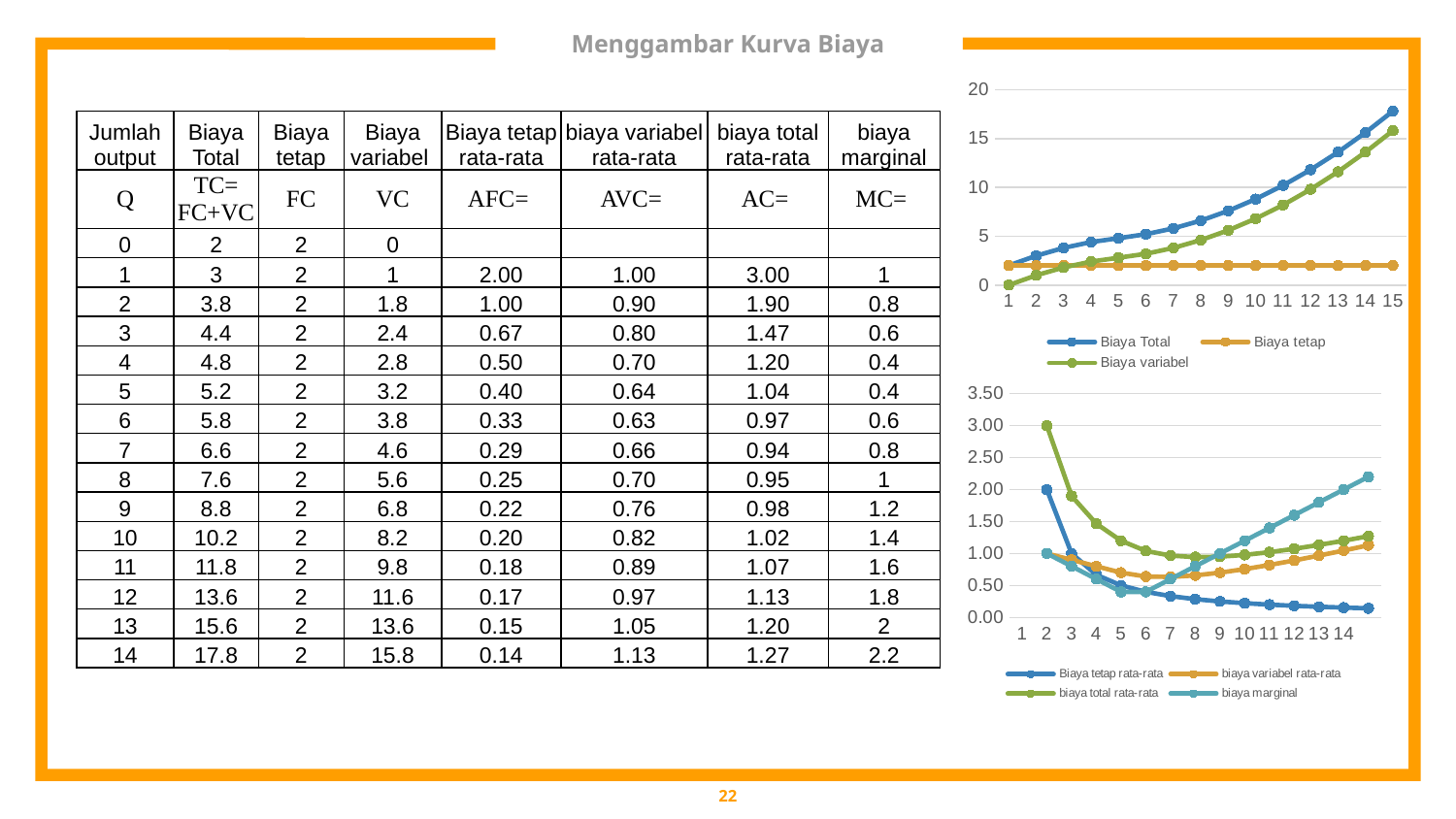
In the top chart, which series is highest at x = 15? Biaya Total In the top chart, is the value of Biaya tetap at x = 10 greater or less than 5? less In the top chart, does the Biaya Total series rise or fall along the x axis? rise In the bottom chart, which series is lowest at the right end of the x axis? Biaya tetap rata-rata In the bottom chart, is the first plotted value of biaya total rata-rata greater or less than 2.50? greater How many series does the legend of the top chart list? 3 In the bottom chart, does the Biaya tetap rata-rata series rise or fall along the x axis? fall In the top chart, is the value of Biaya Total at x = 15 greater or less than 15? greater In the top chart, how many x-axis categories are shown? 15 What colour is the Biaya Total line in the top chart? blue How many series does the legend of the bottom chart list? 4 What kind of chart is the top chart on the slide? line chart